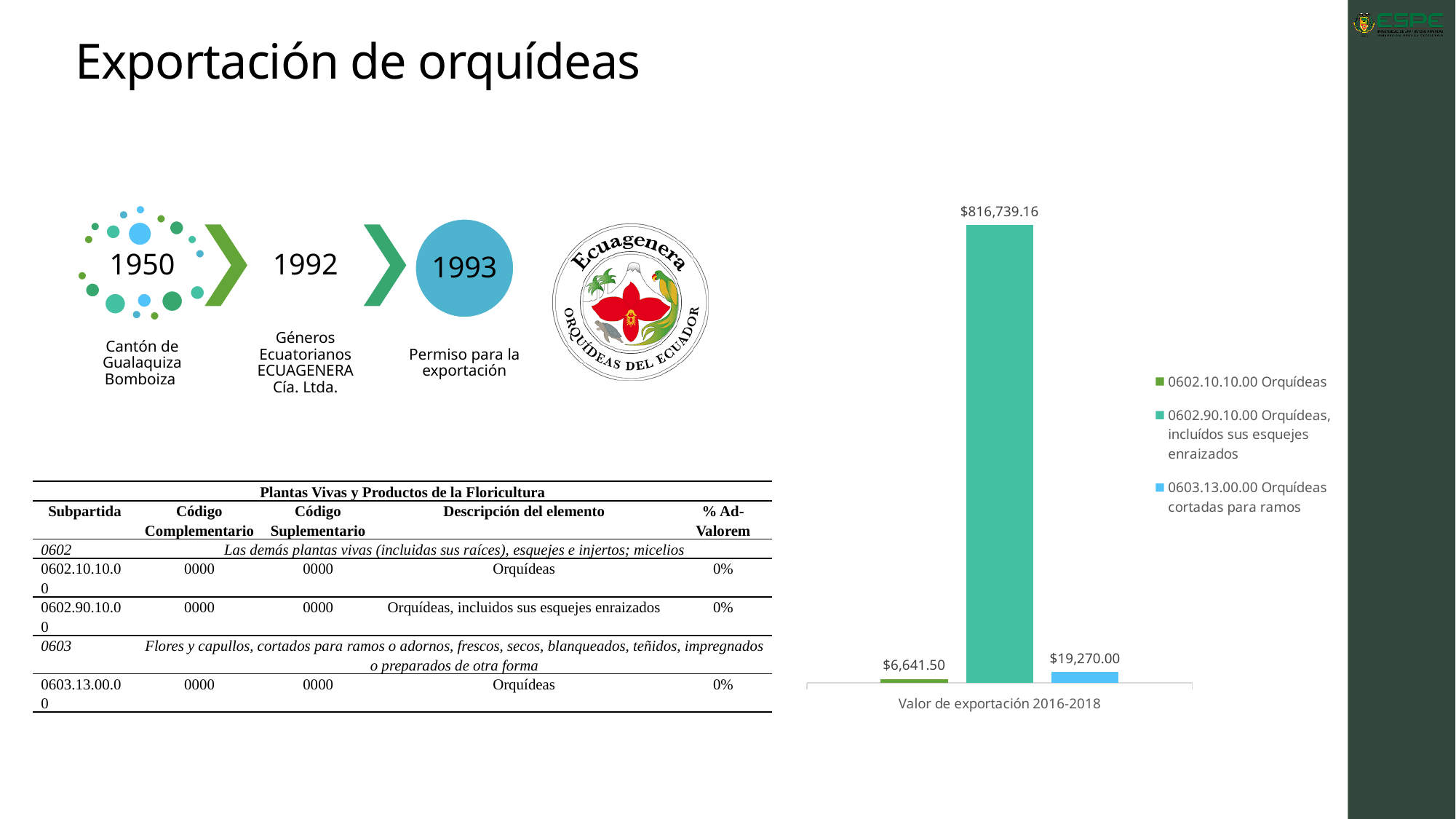
What is the difference between the export values of 0603.13.00.00 Orquídeas cortadas para ramos and 0602.10.10.00 Orquídeas? $12,628.50 What is the export value for 0603.13.00.00 Orquídeas cortadas para ramos? $19,270.00 What is the category label shown on the x axis of the chart? Valor de exportación 2016-2018 Which series has the lowest export value? 0602.10.10.00 Orquídeas What colour is the bar for 0603.13.00.00 Orquídeas cortadas para ramos? light blue What is the export value for 0602.90.10.00 Orquídeas, incluídos sus esquejes enraizados? $816,739.16 Which is larger, the export value for 0603.13.00.00 Orquídeas cortadas para ramos or for 0602.10.10.00 Orquídeas? 0603.13.00.00 Orquídeas cortadas para ramos What type of chart is shown on the slide? bar chart Which series has the highest export value? 0602.90.10.00 Orquídeas, incluídos sus esquejes enraizados What is the difference between the export values of 0602.90.10.00 and 0603.13.00.00? $797,469.16 What is the export value for 0602.10.10.00 Orquídeas? $6,641.50 How many series does the chart legend list? 3